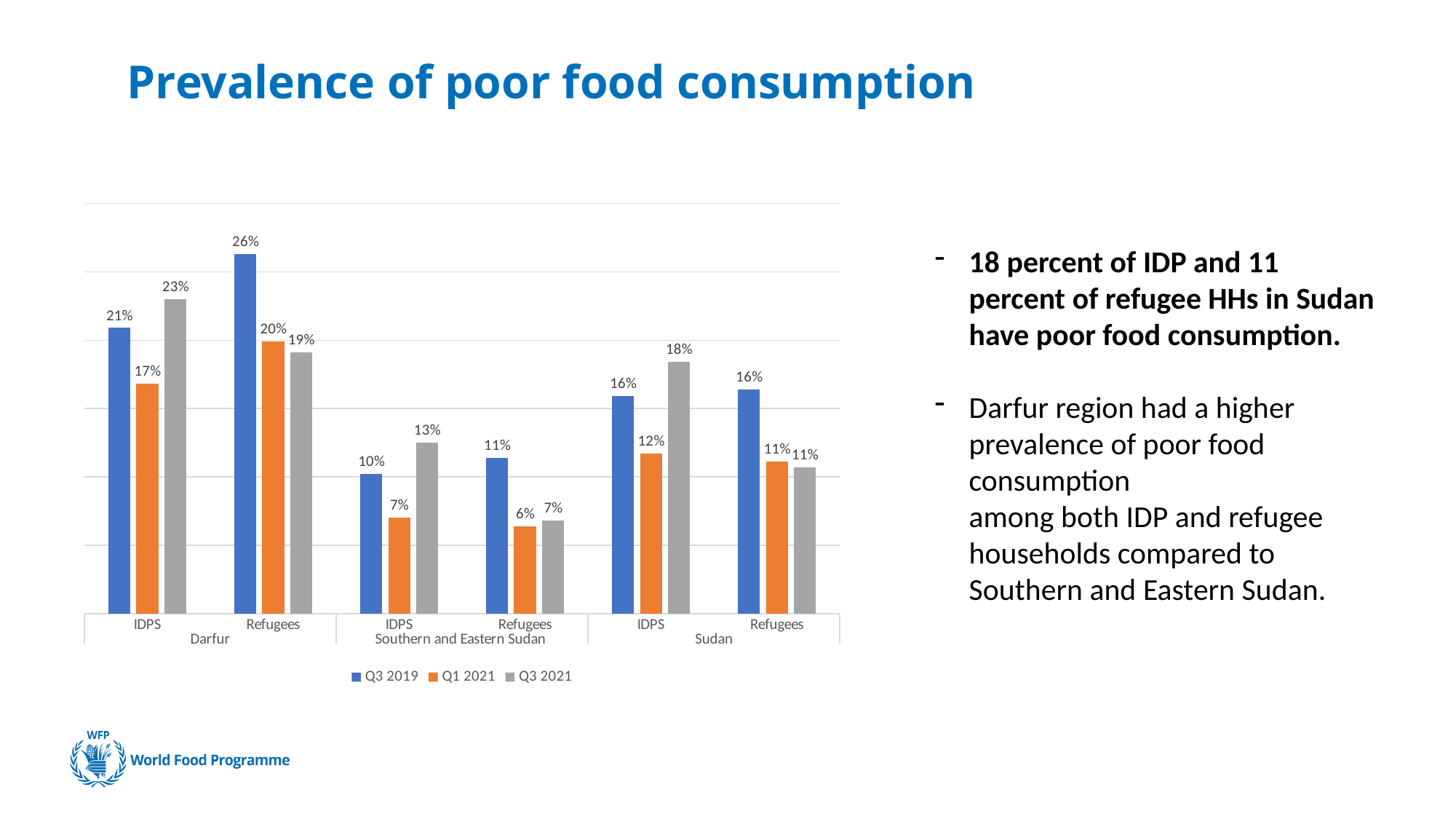
What kind of chart is shown on the slide? Bar chart What is the title of the slide containing the chart? Prevalence of poor food consumption How many series does the legend list? 3 What is the difference between the Q3 2021 and Q1 2021 values for IDPS in Darfur? 6% How many groups of bars (category labels) are shown on the x axis? 6 What is the Q3 2021 value for IDPS in Sudan? 18% What is the Q3 2019 value for Refugees in Darfur? 26% Which group and region has the lowest Q1 2021 value? Refugees in Southern and Eastern Sudan Which group and region has the highest Q3 2019 value? Refugees in Darfur Which colour represents the Q1 2021 series? Orange Which is larger for Refugees in Darfur: the Q1 2021 value or the Q3 2021 value? Q1 2021 What is the Q1 2021 value for IDPS in Southern and Eastern Sudan? 7%